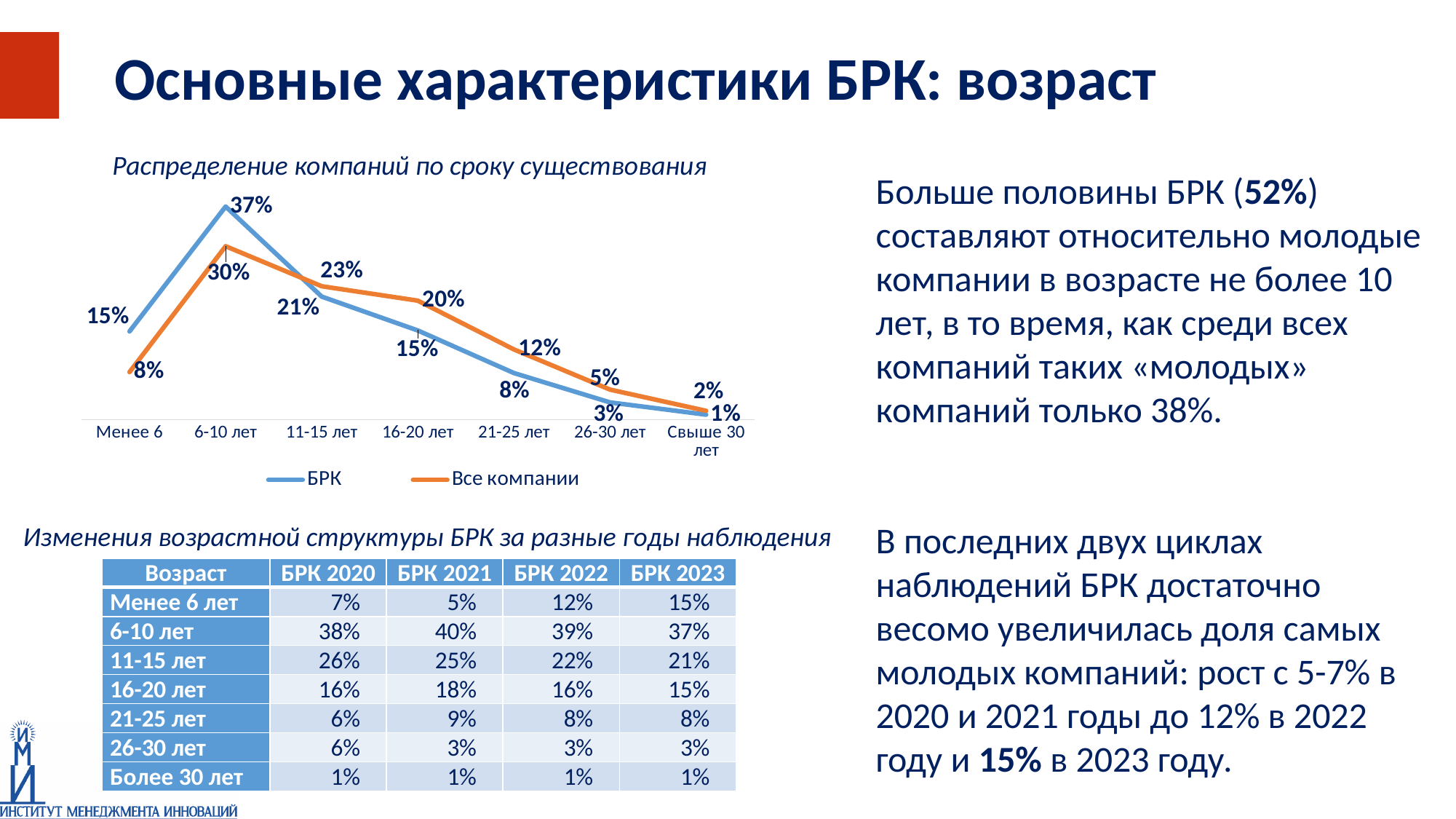
In the line chart, what is the difference between БРК and «Все компании» in the «Менее 6» category? 7% How many series does the legend of the line chart list? 2 In the line chart, which category has the lowest value for the «Все компании» series? Свыше 30 лет In the line chart, what is the value for БРК in the «21-25 лет» category? 8% In the line chart, what is the value for БРК in the «6-10 лет» category? 37% In the line chart, do the БРК values rise or fall from «6-10 лет» to «Свыше 30 лет»? fall In the line chart, what is the value for «Все компании» in the «Менее 6» category? 8% What colour is the line for the «Все компании» series in the line chart? orange In the line chart, which category has the highest value for the БРК series? 6-10 лет In the line chart, which series has the larger value in the «16-20 лет» category, БРК or «Все компании»? Все компании What type of chart is shown under the title «Распределение компаний по сроку существования»? line chart How many age categories are shown on the x axis of the line chart? 7